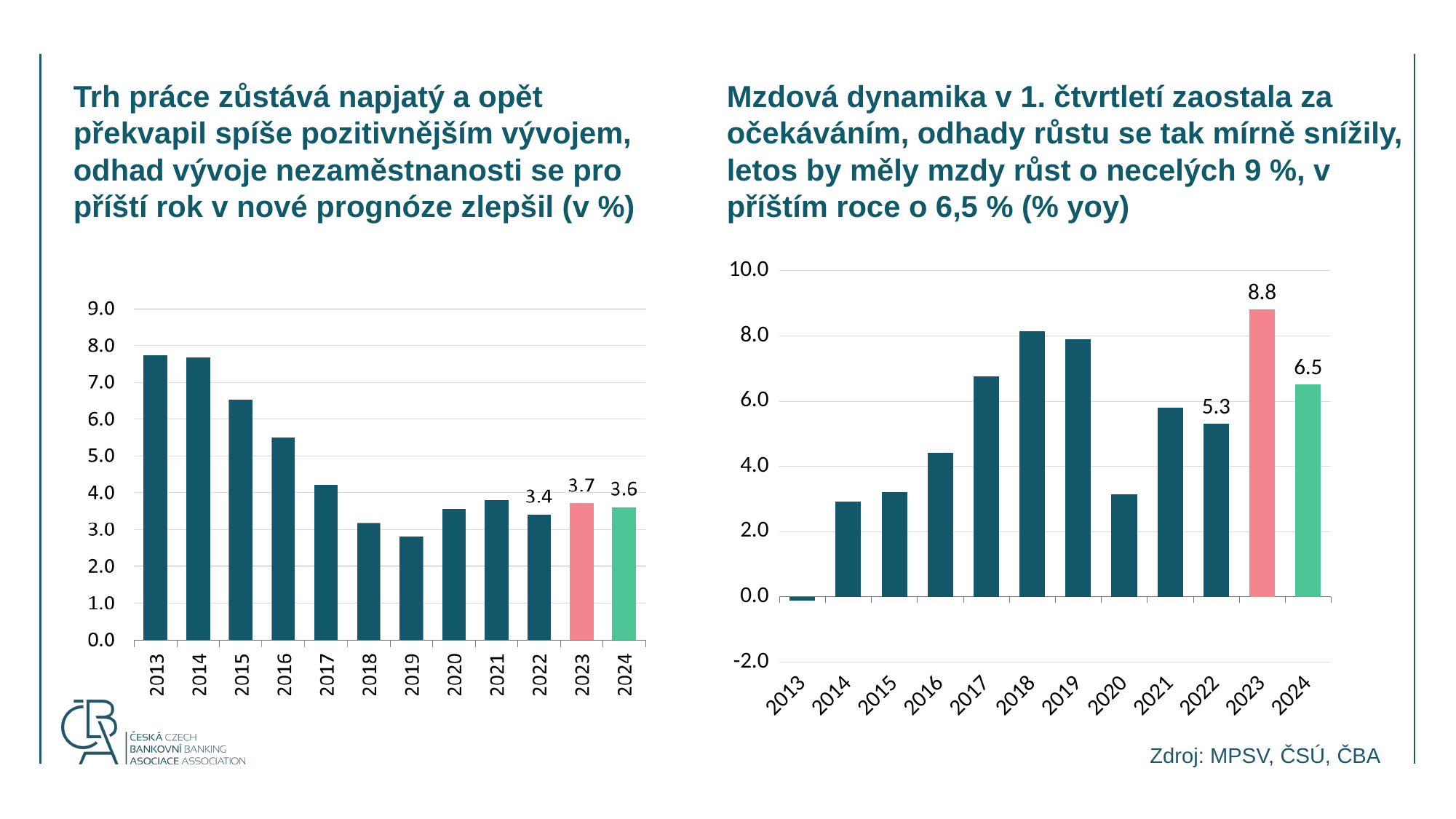
In the right chart (wage growth), what is the value for 2024? 6.5 In the left chart (unemployment), which year has the lowest value? 2019 In the left chart (unemployment), is the value for 2023 larger or smaller than the value for 2024? larger In the left chart (unemployment), is the value for 2015 greater or less than 6.0? greater In the left chart (unemployment), what is the value for 2022? 3.4 How many years are shown on the x axis of the left chart? 12 In the right chart (wage growth), what is the difference between the 2023 and 2024 values? 2.3 In the right chart (wage growth), what is the value for 2023? 8.8 In the right chart (wage growth), which year has the highest value? 2023 In the left chart (unemployment), what is the value for 2023? 3.7 In the right chart (wage growth), which year has the lowest value? 2013